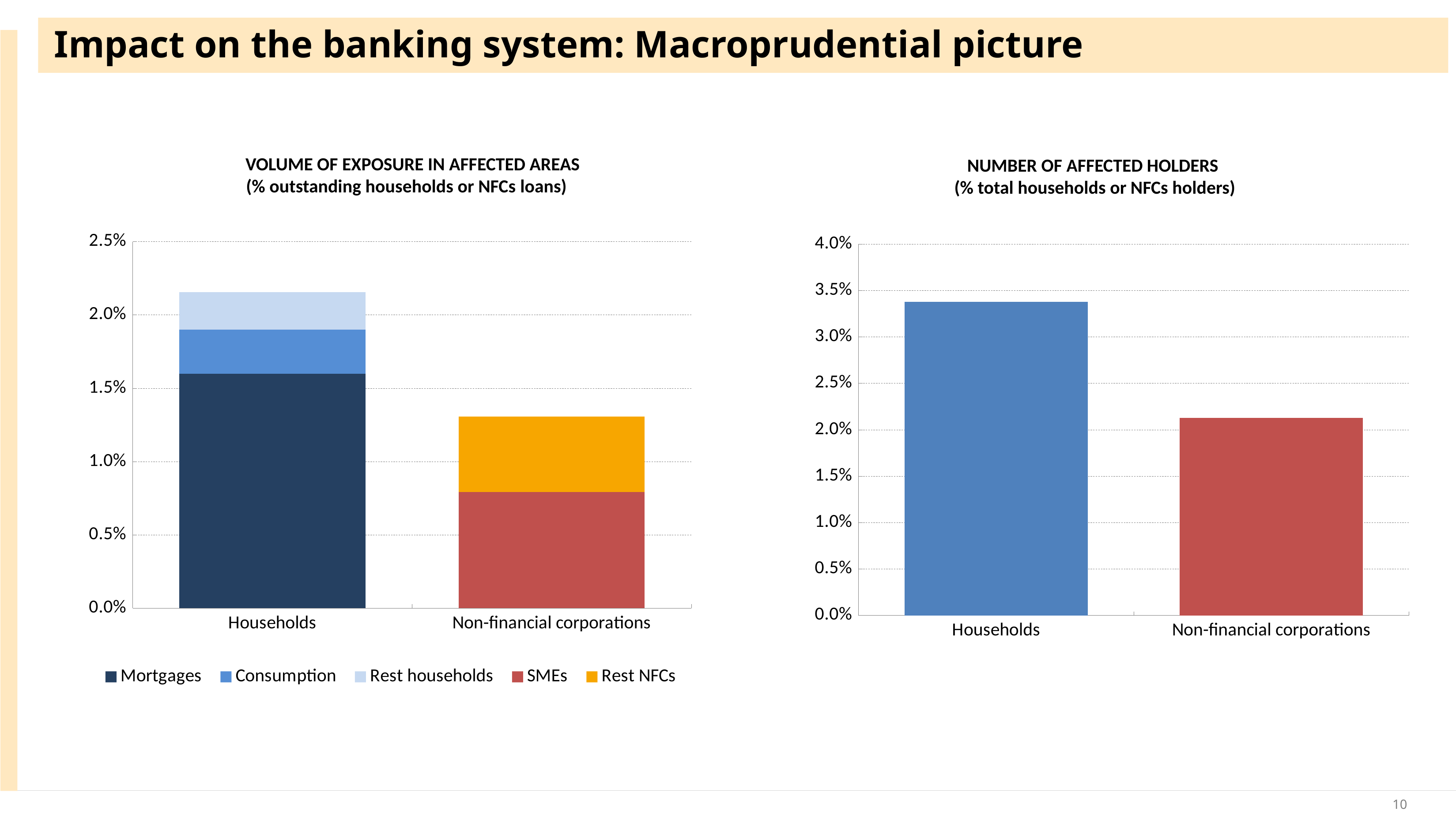
On the left chart (Volume of exposure in affected areas), how many series does the legend list? 5 On the left chart (Volume of exposure in affected areas), which category has the taller stacked bar? Households On the left chart (Volume of exposure in affected areas), is the SMEs segment for Non-financial corporations greater or less than 1.0%? less On the left chart (Volume of exposure in affected areas), is the total value for Non-financial corporations greater or less than 1.5%? less On the left chart (Volume of exposure in affected areas), is the Mortgages segment for Households greater or less than 1.5%? greater On the left chart (Volume of exposure in affected areas), which legend entry is shown in orange? Rest NFCs On the right chart (Number of affected holders), how many categories are shown on the x axis? 2 On the right chart (Number of affected holders), which category has the lowest value? Non-financial corporations On the left chart (Volume of exposure in affected areas), what kind of chart is shown? Stacked bar chart